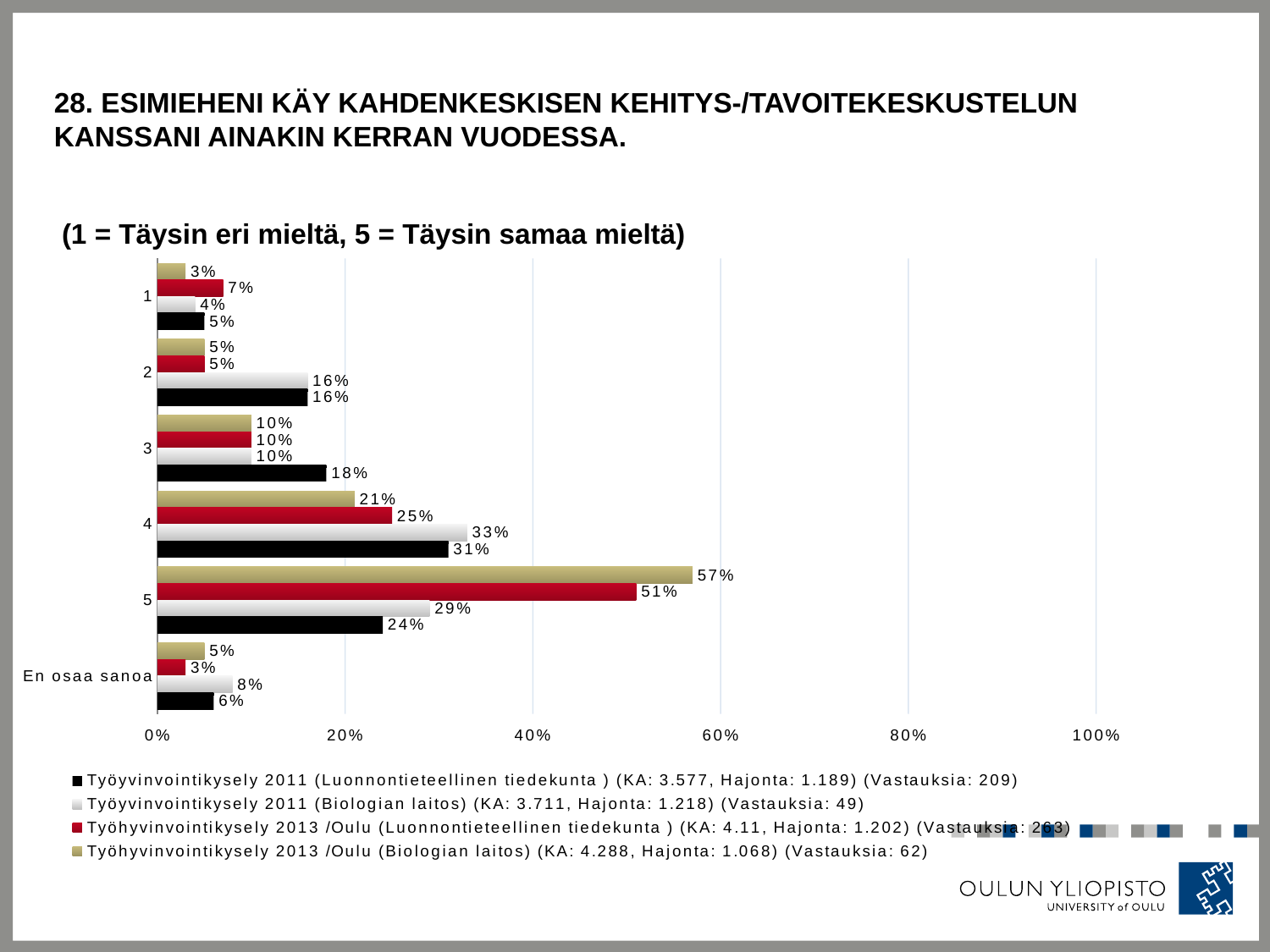
What is the value for 'En osaa sanoa' in the Työhyvinvointikysely 2013 /Oulu (Luonnontieteellinen tiedekunta) series? 3% What is the value for category 3 in the Työyvinvointikysely 2011 (Luonnontieteellinen tiedekunta) series? 18% Which category has the highest value in the Työhyvinvointikysely 2013 /Oulu (Biologian laitos) series? 5 Which category has the lowest value in the Työhyvinvointikysely 2013 /Oulu (Luonnontieteellinen tiedekunta) series? En osaa sanoa What is the difference between the Työhyvinvointikysely 2013 /Oulu (Biologian laitos) value and the Työyvinvointikysely 2011 (Luonnontieteellinen tiedekunta) value for category 5? 33% What is the value for category 4 in the Työyvinvointikysely 2011 (Biologian laitos) series? 33% Is the value for category 5 in the Työhyvinvointikysely 2013 /Oulu (Luonnontieteellinen tiedekunta) series greater or less than 40%? greater What kind of chart is shown on the slide? Bar chart What is the value for category 5 in the Työhyvinvointikysely 2013 /Oulu (Biologian laitos) series? 57% For category 4, which is larger: the Työyvinvointikysely 2011 (Biologian laitos) value or the Työhyvinvointikysely 2013 /Oulu (Biologian laitos) value? Työyvinvointikysely 2011 (Biologian laitos) How many categories are shown on the vertical axis of the chart? 6 How many series does the legend list? 4